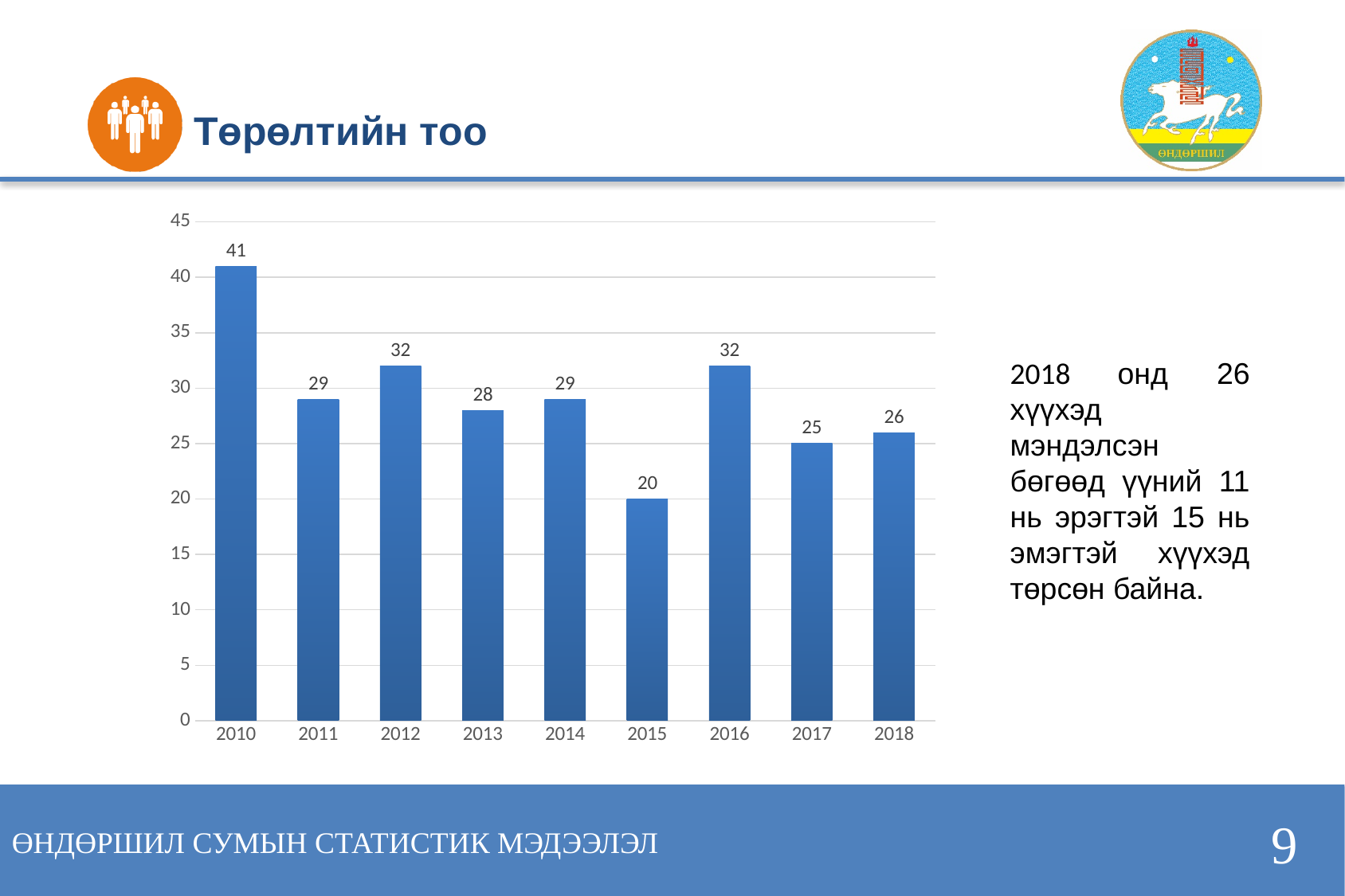
What is the value for 2015? 20 Is the value for 2012 greater or less than 30? greater Which year has the highest value? 2010 How many years are shown on the x axis? 9 What is the value for 2010? 41 Which is larger, the value for 2013 or the value for 2016? 2016 What is the title of the slide containing the chart? Төрөлтийн тоо What is the difference between the values for 2017 and 2018? 1 What is the value for 2018? 26 What is the difference between the values for 2010 and 2015? 21 Which year has the lowest value? 2015 What kind of chart is shown on the slide? bar chart